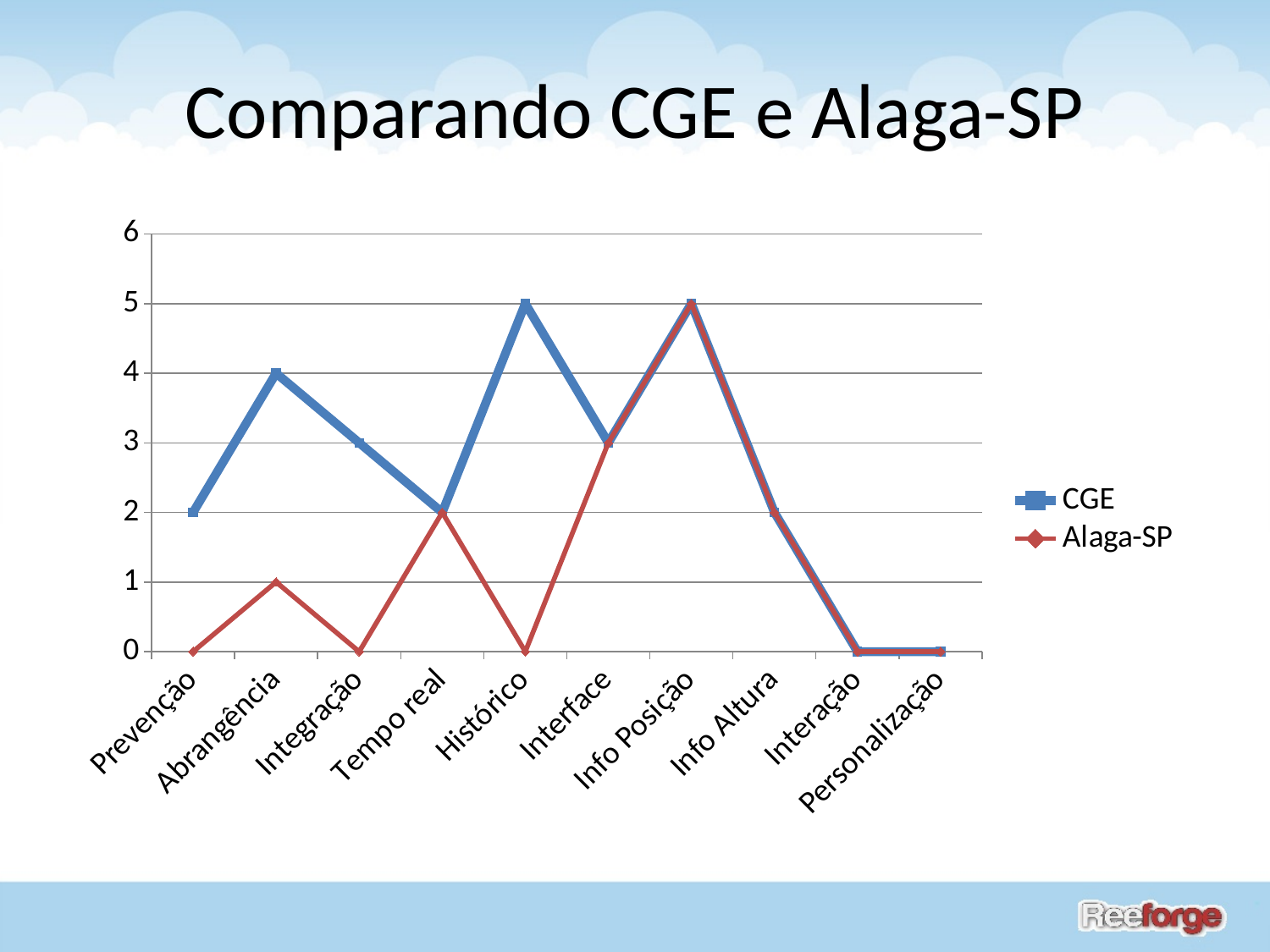
What is the value for Alaga-SP at Interface? 3 What kind of chart is shown on the slide? line chart How many categories are shown on the x axis? 10 What is the value for CGE at Prevenção? 2 How many series does the legend list? 2 What is the title of the chart slide? Comparando CGE e Alaga-SP What is the difference between the CGE and Alaga-SP values at Histórico? 5 What is the value for CGE at Histórico? 5 Which series has the higher value at Abrangência, CGE or Alaga-SP? CGE What is the value for Alaga-SP at Abrangência? 1 At which category does Alaga-SP reach its highest value? Info Posição Is the value for CGE at Abrangência greater or less than 3? greater